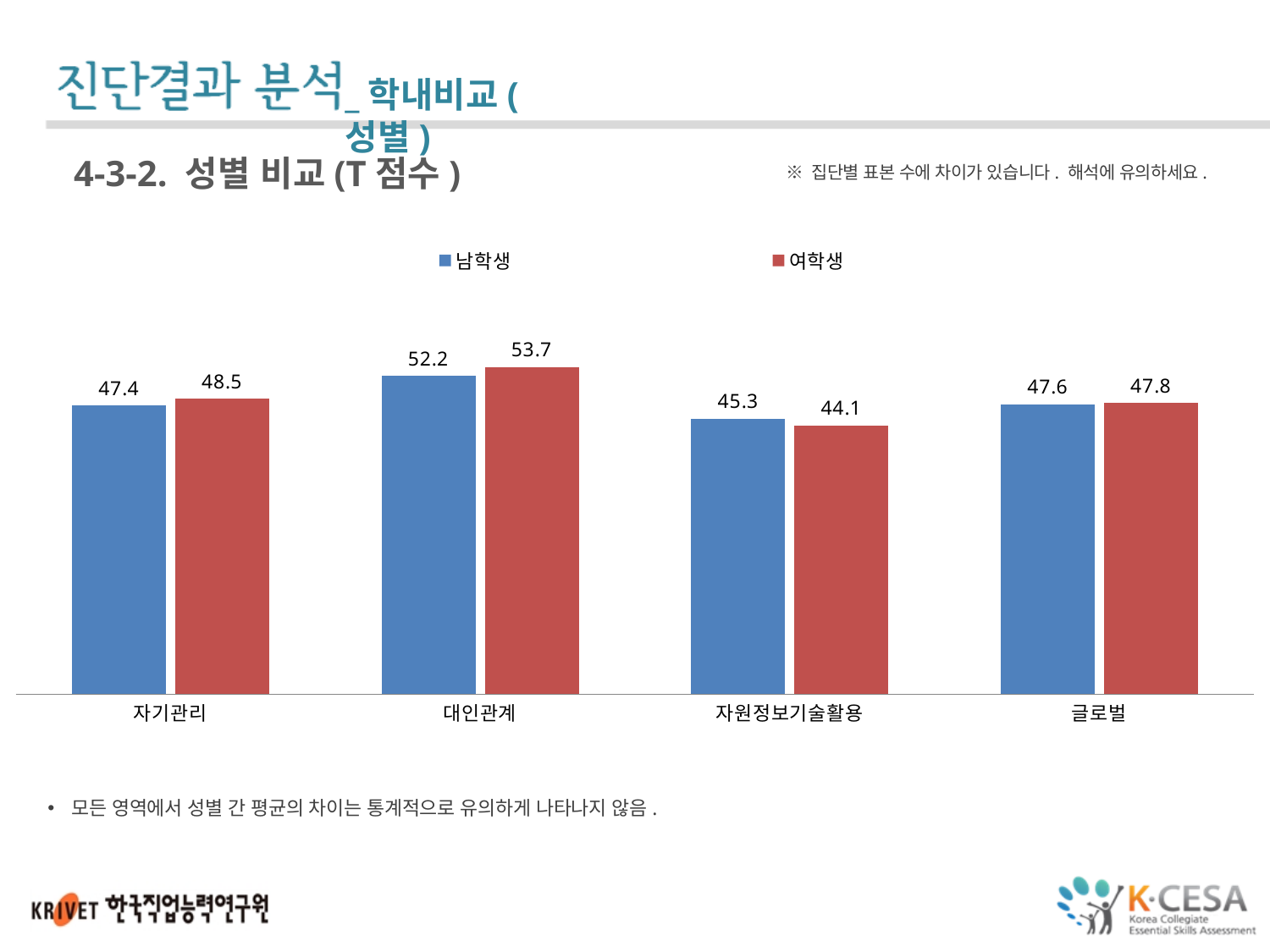
What is the value for 남학생 in the 자원정보기술활용 category? 45.3 Which series is shown in red? 여학생 In which category is the 남학생 value lowest? 자원정보기술활용 How many series does the legend list? 2 What is the difference between the 여학생 and 남학생 values in the 대인관계 category? 1.5 What is the value for 여학생 in the 글로벌 category? 47.8 In which category is the 여학생 value highest? 대인관계 How many categories are shown on the x axis? 4 Which is larger in the 자원정보기술활용 category, the 남학생 value or the 여학생 value? 남학생 What kind of chart is shown on the slide? bar chart What is the value for 남학생 in the 자기관리 category? 47.4 What is the value for 여학생 in the 대인관계 category? 53.7